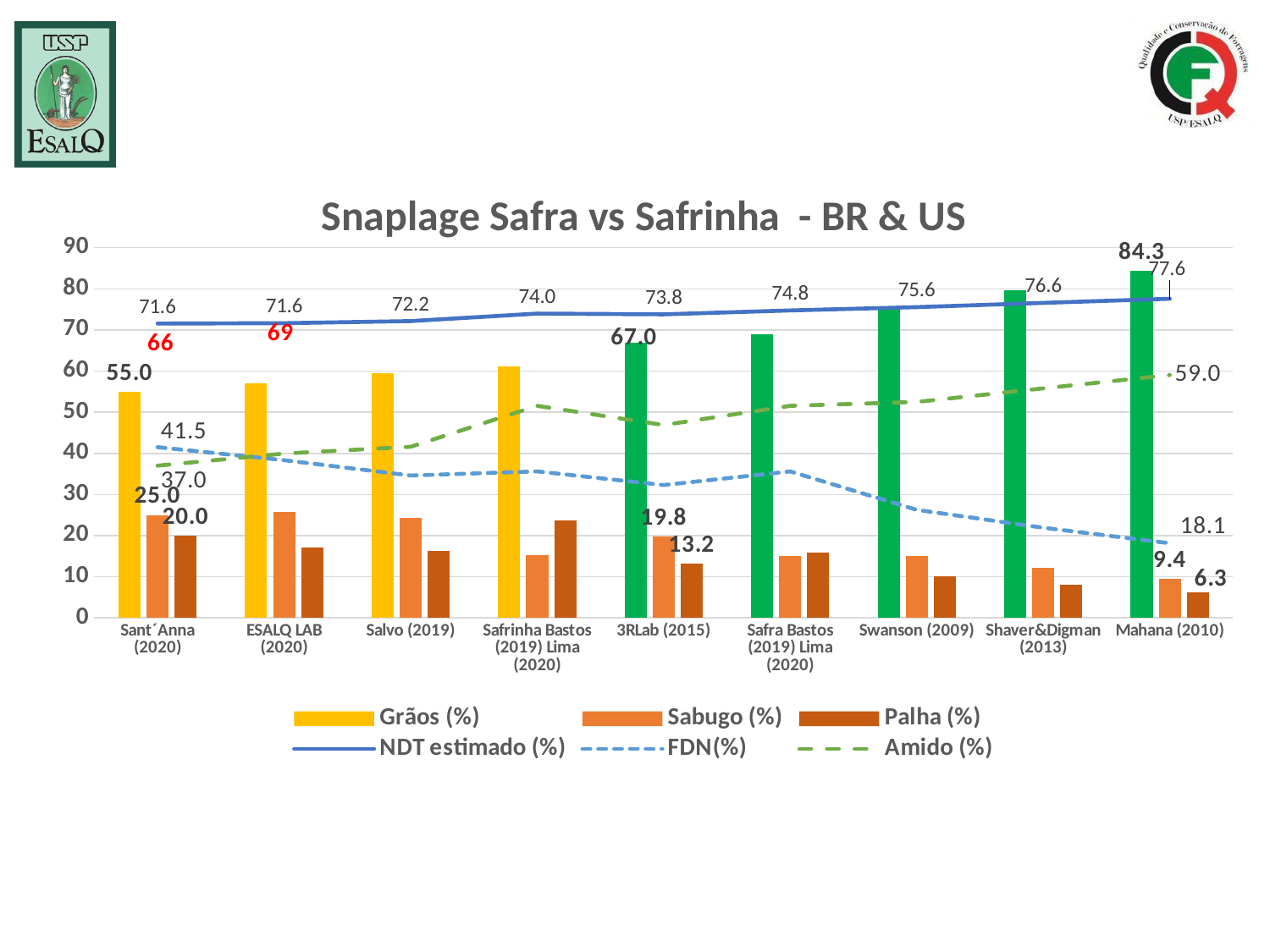
Does the FDN(%) line rise or fall from left to right along the x axis? falls How many categories are shown on the x axis? 9 Is the Grãos (%) value for Safra Bastos (2019) Lima (2020) greater or less than 60? greater What is the Palha (%) value for 3RLab (2015)? 13.2 What is the Grãos (%) value for Mahana (2010)? 84.3 Which category has the lowest Palha (%) value? Mahana (2010) What is the NDT estimado (%) value for Swanson (2009)? 75.6 Which category has the highest NDT estimado (%) value? Mahana (2010) What is the difference between the Grãos (%) value for Mahana (2010) and for Sant´Anna (2020)? 29.3 Which has the larger Sabugo (%) value, Sant´Anna (2020) or 3RLab (2015)? Sant´Anna (2020) How many series does the legend list? 6 What is the Amido (%) value for Mahana (2010)? 59.0